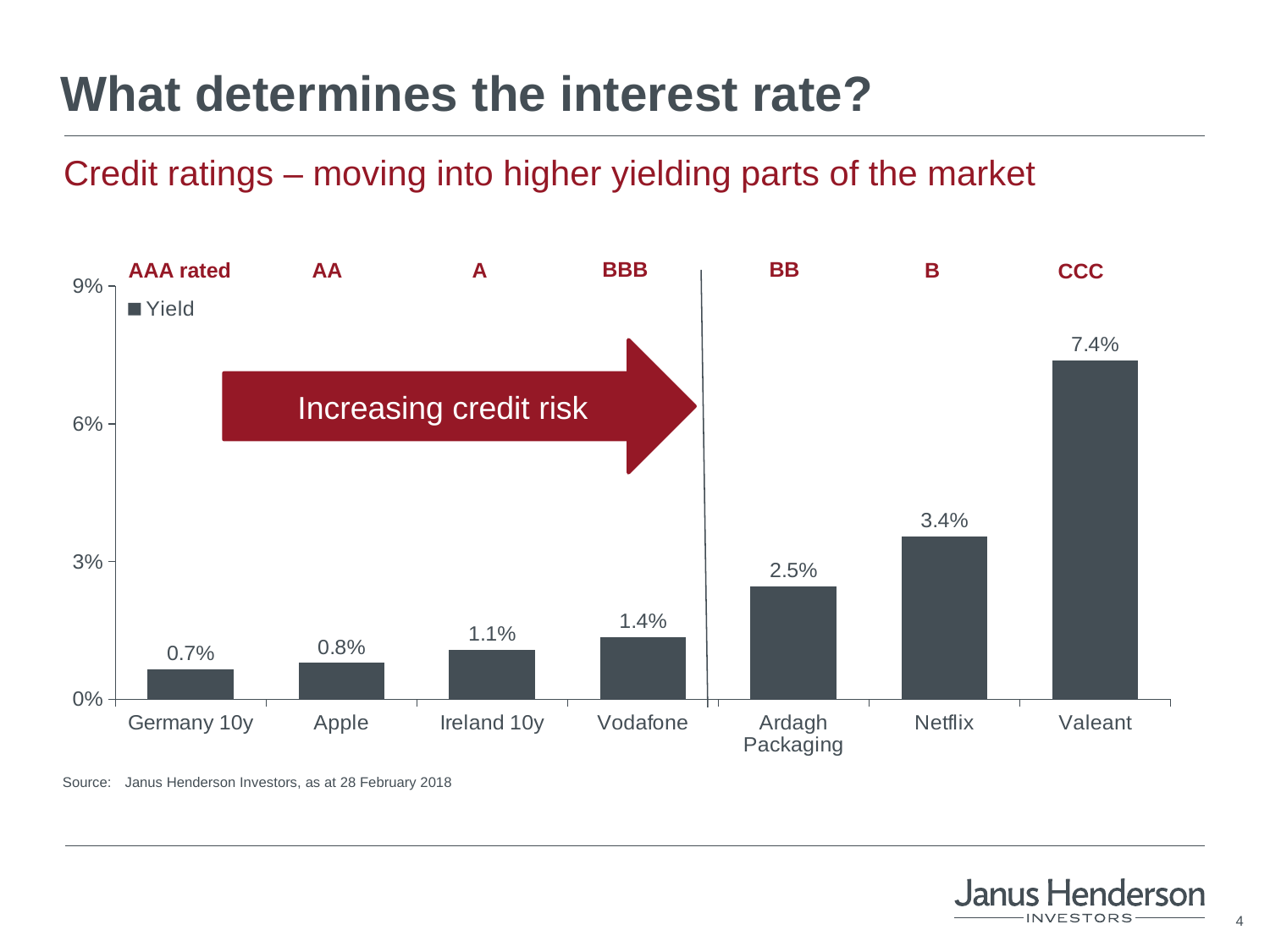
What is the yield for Ardagh Packaging? 2.5% What kind of chart is shown? Bar chart Which category has the lowest yield? Germany 10y Which category has the highest yield? Valeant How many series does the legend list? 1 Do the yields rise or fall moving from left to right along the x axis? Rise What is the yield for Netflix? 3.4% Which has a higher yield, Apple or Ireland 10y? Ireland 10y Is the yield for Valeant greater or less than 6%? greater How many categories are shown on the x axis? 7 What is the yield for Germany 10y? 0.7% What is the difference in yield between Valeant and Vodafone? 6.0%